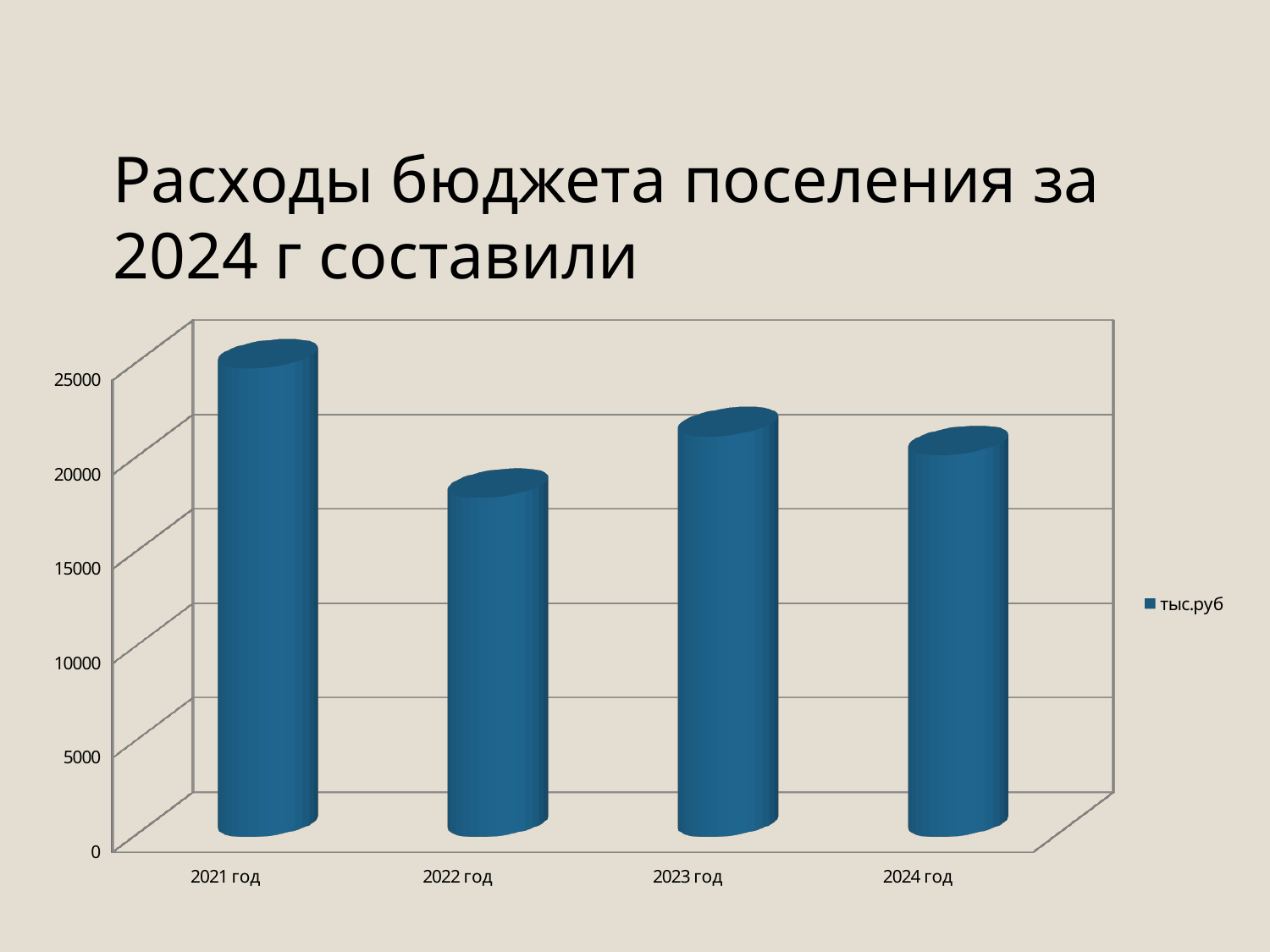
How many categories (years) are shown on the x axis? 4 Is the value for 2024 год greater or less than 15000? greater Which year has the highest value? 2021 год Is the value for 2022 год greater or less than 20000? less Which is larger, the value for 2023 год or the value for 2024 год? 2023 год Is the value for 2021 год greater or less than 20000? greater Which is larger, the value for 2021 год or the value for 2022 год? 2021 год How many series does the legend list? 1 What kind of chart is shown on the slide? bar chart Which year has the lowest value? 2022 год What is the legend entry of the chart? тыс.руб